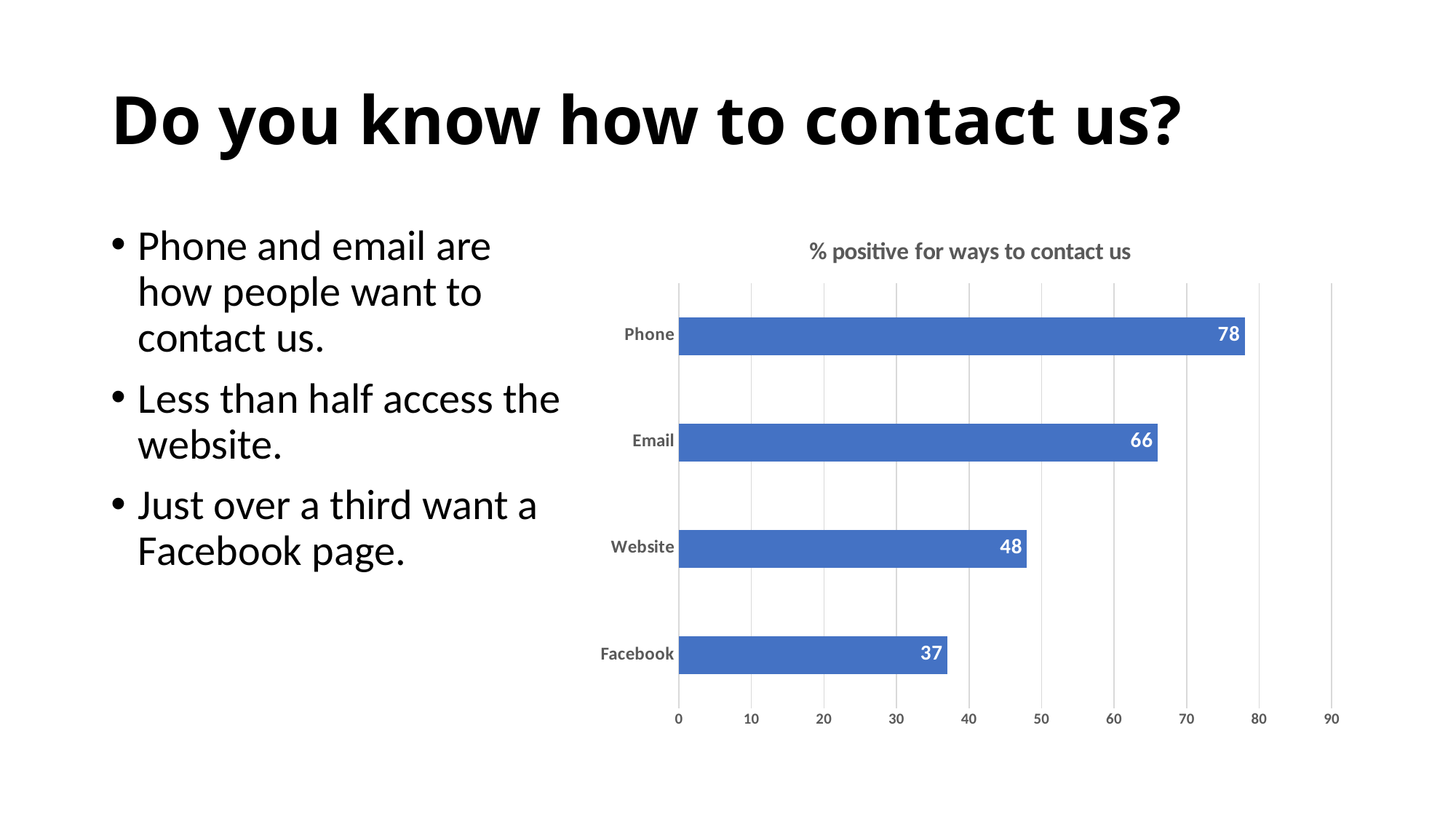
Which category has the lowest value? Facebook Which category has the highest value? Phone What is the value for Email? 66 What is the value for Facebook? 37 Is the value for Website greater or less than 50? less What is the value for Phone? 78 Which is larger, the value for Email or the value for Website? Email What is the difference between the values for Website and Facebook? 11 How many categories are shown in the chart? 4 What is the value for Website? 48 What is the title of the chart? % positive for ways to contact us What is the difference between the values for Phone and Email? 12